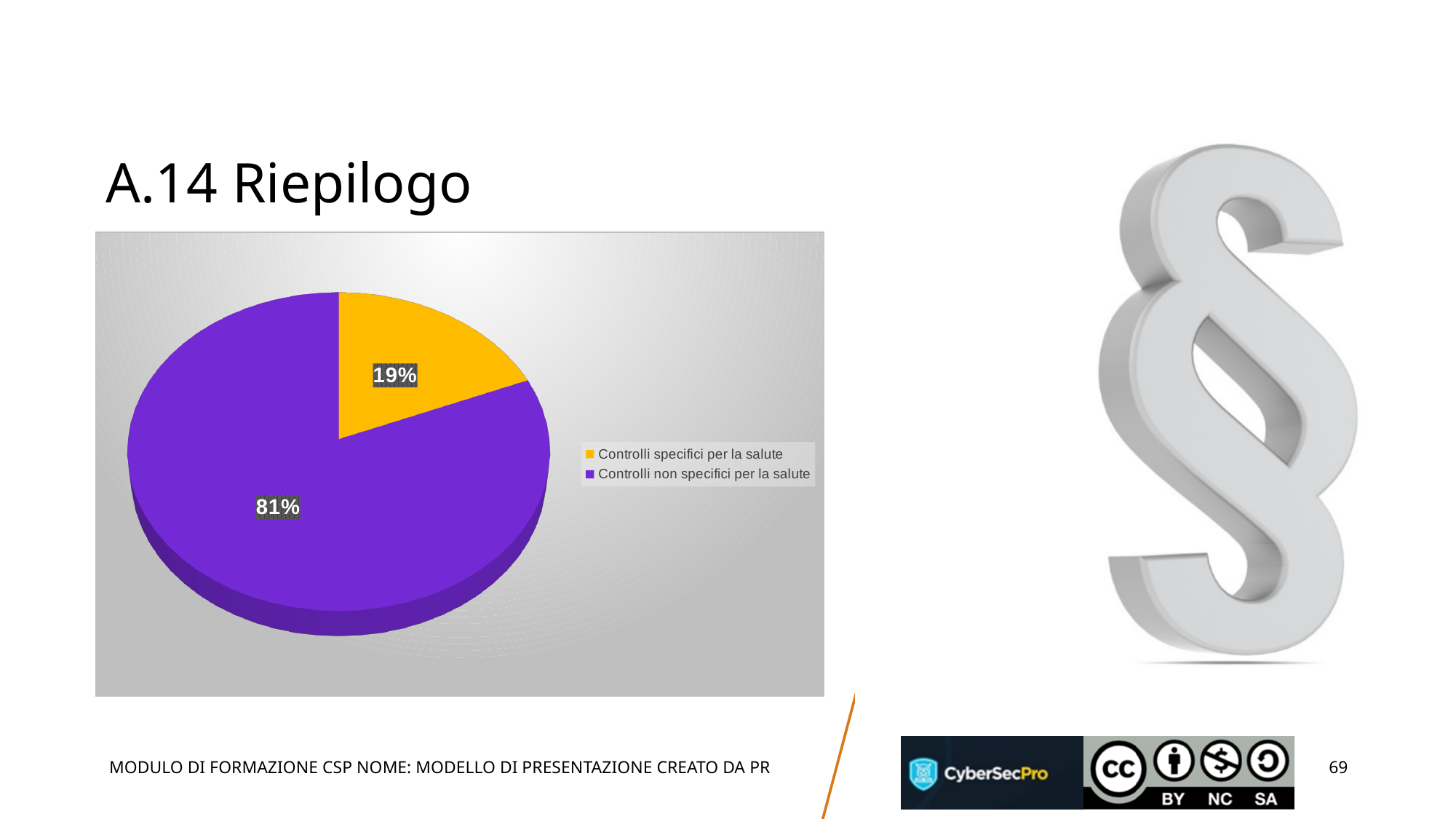
How many slices does the pie chart have? 2 Which is larger: the 'Controlli specifici per la salute' slice or the 'Controlli non specifici per la salute' slice? Controlli non specifici per la salute What colour is the 'Controlli specifici per la salute' slice? orange What kind of chart is shown on the slide? pie chart What share of the pie is 'Controlli non specifici per la salute'? 81% What is the difference in percentage points between the 'Controlli non specifici per la salute' slice and the 'Controlli specifici per la salute' slice? 62 What share of the pie is 'Controlli specifici per la salute'? 19% What colour is the 'Controlli non specifici per la salute' slice? purple How many entries does the legend list? 2 Which category has the largest slice of the pie? Controlli non specifici per la salute Which category has the smallest slice of the pie? Controlli specifici per la salute